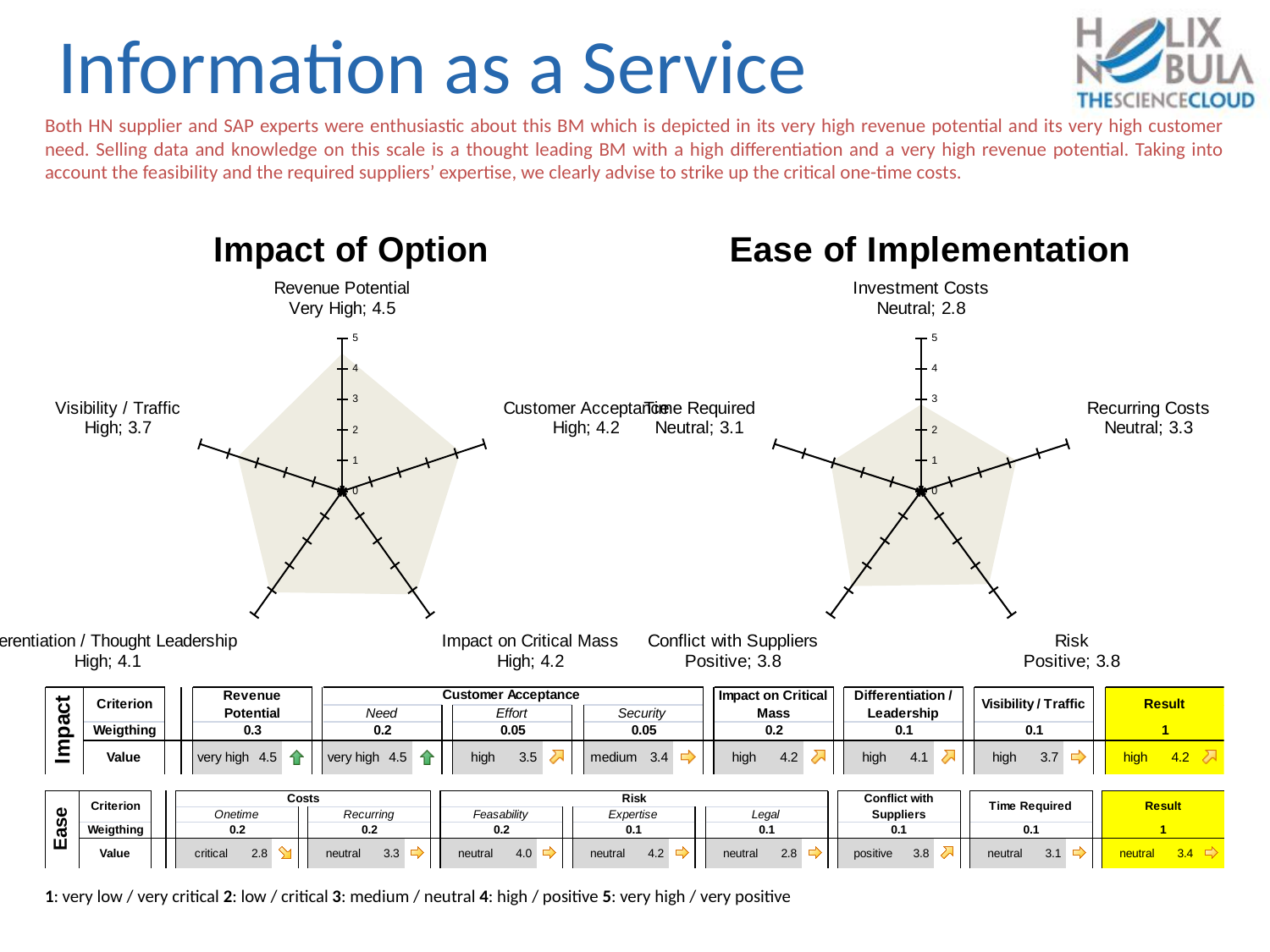
In the Impact of Option chart, which criterion has the lowest value? Visibility / Traffic In the Impact of Option chart, what is the value for Revenue Potential? 4.5 In the Impact of Option chart, what is the value for Visibility / Traffic? 3.7 In the Ease of Implementation chart, what rating label is shown for Recurring Costs? Neutral In the Ease of Implementation chart, what is the difference between the values for Risk and Investment Costs? 1.0 In the Ease of Implementation chart, what is the value for Time Required? 3.1 How many criteria are plotted in the Ease of Implementation chart? 5 In the Ease of Implementation chart, which criterion has the lowest value? Investment Costs In the Ease of Implementation chart, what is the value for Investment Costs? 2.8 What kind of chart is the Impact of Option chart? Radar chart In the Impact of Option chart, which is larger: the value for Revenue Potential or the value for Visibility / Traffic? Revenue Potential In the Impact of Option chart, which criterion has the highest value? Revenue Potential